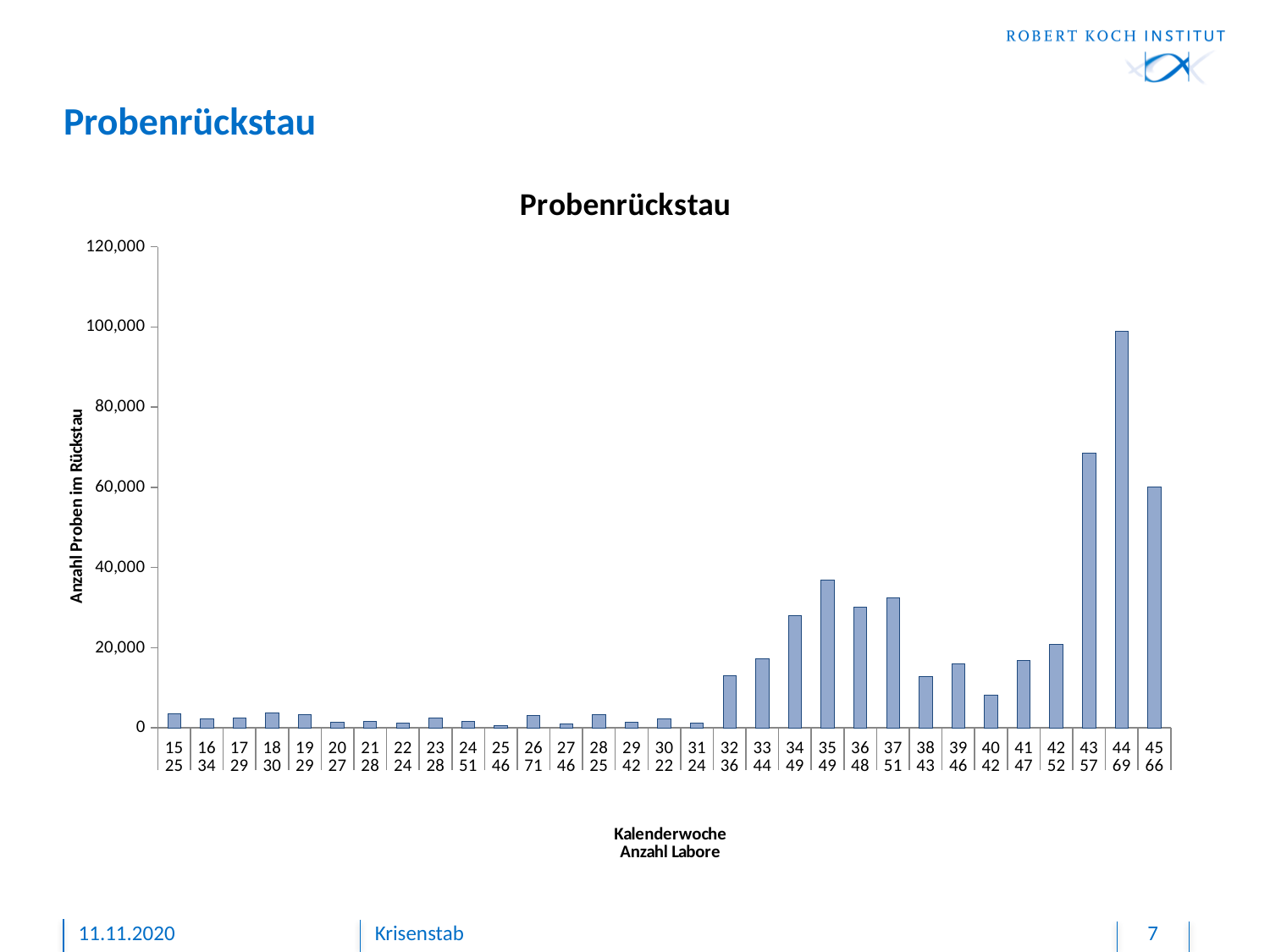
Is the value for calendar week 44 greater or less than 80,000? greater What kind of chart is shown on the slide? bar chart Which calendar week has the highest number of samples in the backlog? 44 Is the value for calendar week 45 greater or less than 80,000? less How many labs (Anzahl Labore) are listed under calendar week 44? 69 What is the title of the y axis? Anzahl Proben im Rückstau Which has the larger backlog, calendar week 43 or calendar week 45? 43 Do the values rise or fall from calendar week 32 to calendar week 35? rise Is the value for calendar week 35 greater or less than 40,000? less How many calendar weeks (categories) are plotted on the x axis? 31